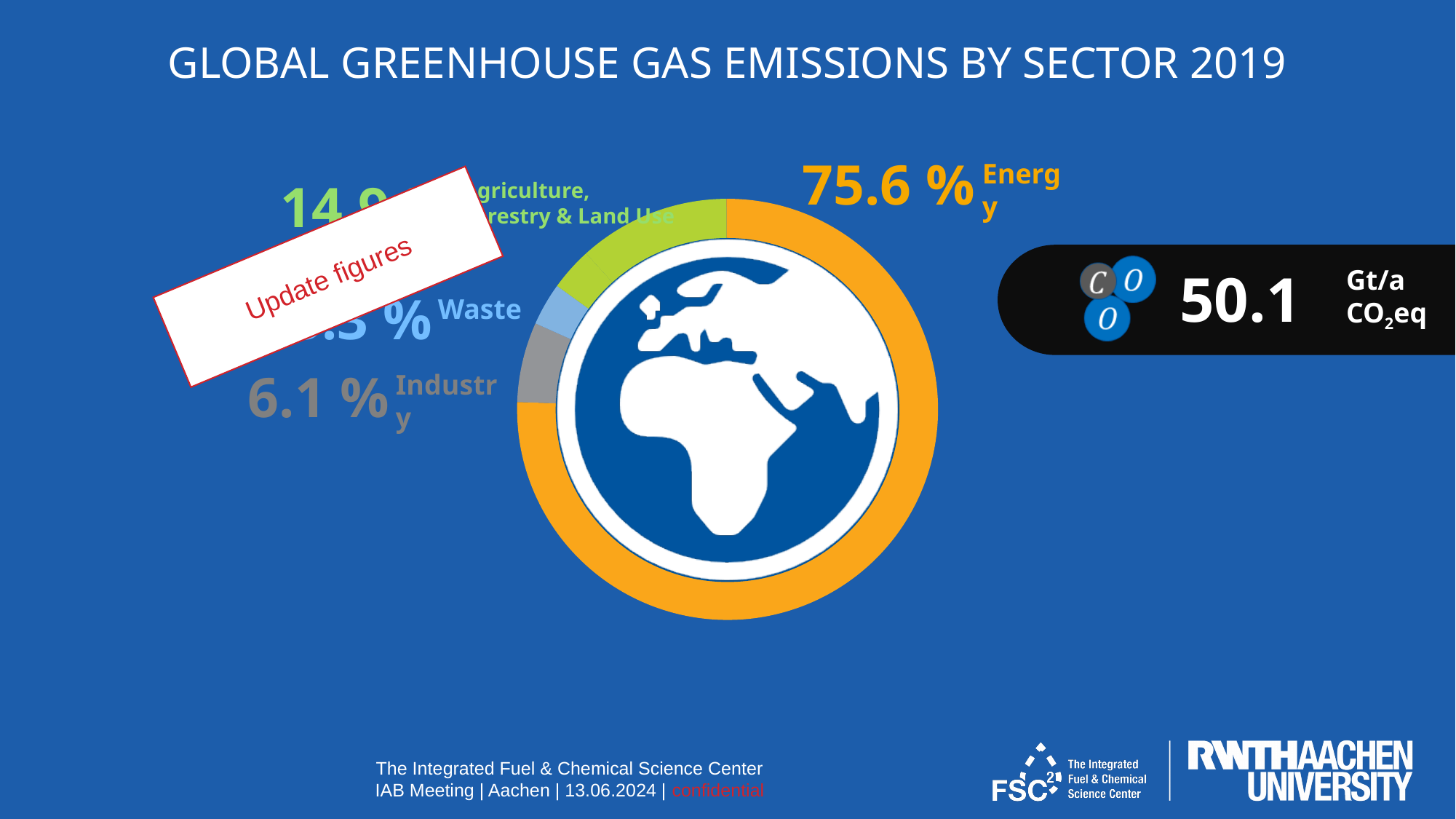
What is the difference in percentage points between the Energy share and the Industry share? 69.5 % What total amount of emissions is stated on the slide? 50.1 Gt/a CO2eq What kind of chart is shown on the slide? Pie (donut) chart What share of global greenhouse gas emissions does the Industry sector account for? 6.1 % What is the title of the slide? GLOBAL GREENHOUSE GAS EMISSIONS BY SECTOR 2019 Is the share for Energy greater or less than 50 %? greater Which sector has the smallest slice in the chart? Waste What share of global greenhouse gas emissions does the Energy sector account for? 75.6 % Which sector has the largest share of global greenhouse gas emissions in the chart? Energy How many sectors are shown in the chart? 4 Which sector has a larger share, Energy or Industry? Energy Which sector has a larger share, Agriculture, Forestry & Land Use or Industry? Agriculture, Forestry & Land Use